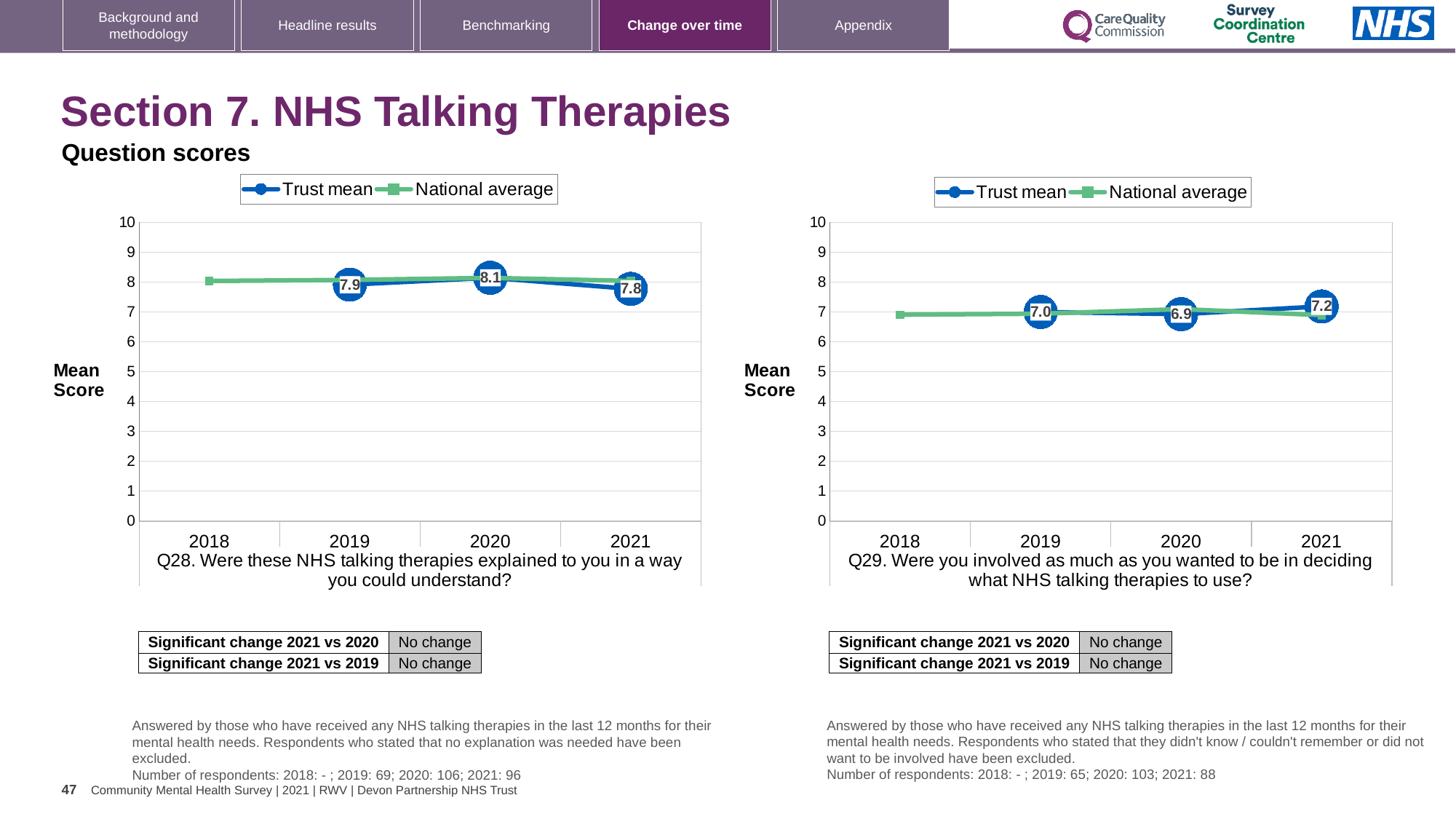
In the Q29 chart (right), does the Trust mean rise or fall from 2020 to 2021? rise In the Q28 chart (left), is the National average for 2018 greater or less than 6? greater In the Q29 chart (right), which year has the lowest Trust mean? 2020 In the Q28 chart (left), what is the difference between the Trust mean for 2020 and 2021? 0.3 What kind of chart is the Q28 chart (left)? line chart In the Q28 chart (left), what is the Trust mean for 2020? 8.1 How many series does the legend of the Q29 chart (right) list? 2 In the Q29 chart (right), what is the Trust mean for 2019? 7.0 In the Q29 chart (right), what is the Trust mean for 2021? 7.2 In the Q28 chart (left), which year has the highest Trust mean? 2020 In the Q29 chart (right), is the Trust mean for 2021 larger or smaller than the Trust mean for 2020? larger In the Q28 chart (left), what is the Trust mean for 2021? 7.8